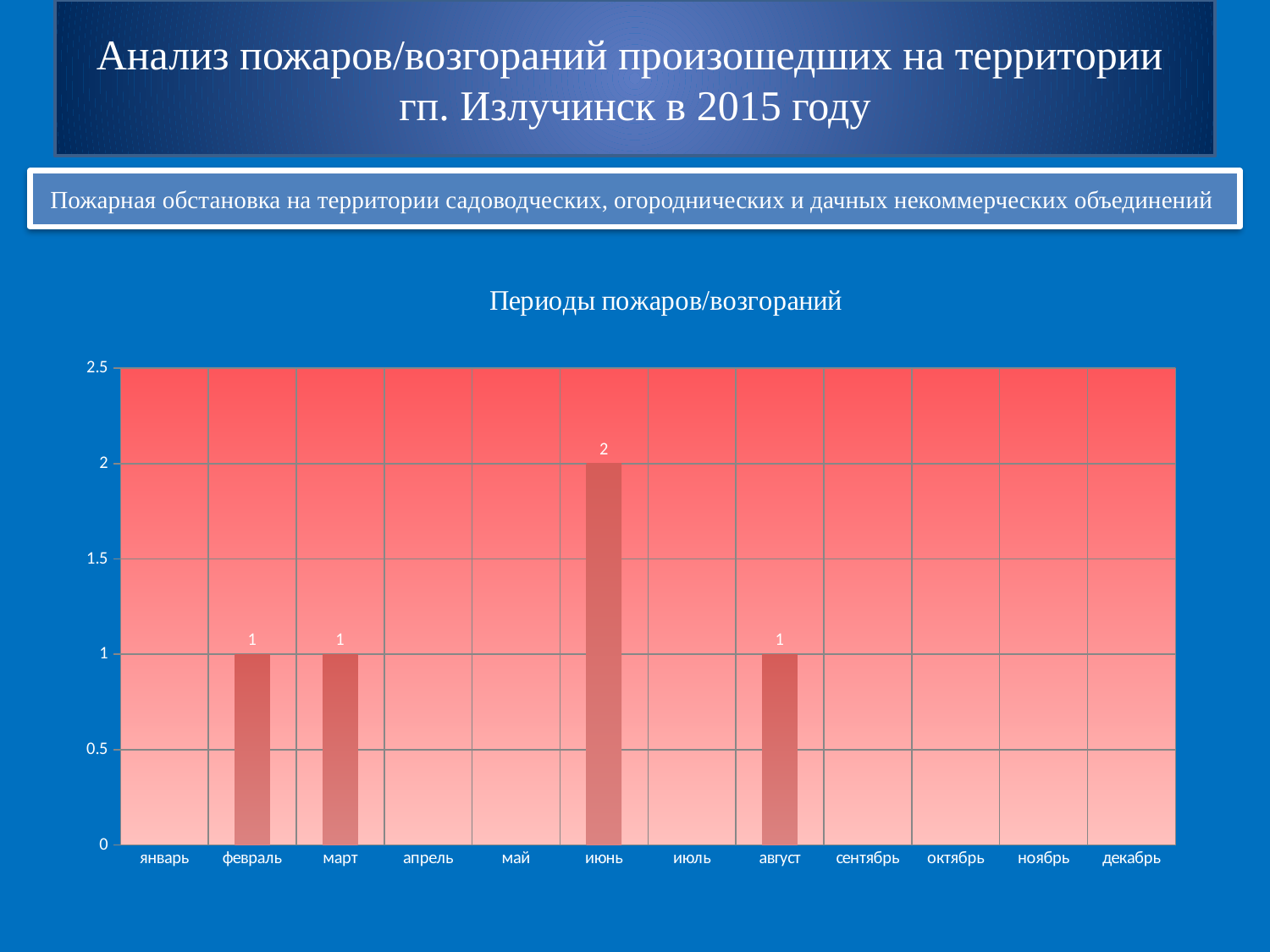
What is the difference between the values for июнь and март? 1 How many months are shown on the x axis? 12 Is the value for июнь greater or less than 1.5? greater What is the highest value shown on the y axis? 2.5 How many months have a bar with a value greater than zero? 4 Which month has the highest value? июнь What is the title of the chart? Периоды пожаров/возгораний What is the value for июнь? 2 What kind of chart is shown? bar chart What is the value for август? 1 Which is larger, the value for июнь or the value for август? июнь What is the value for февраль? 1